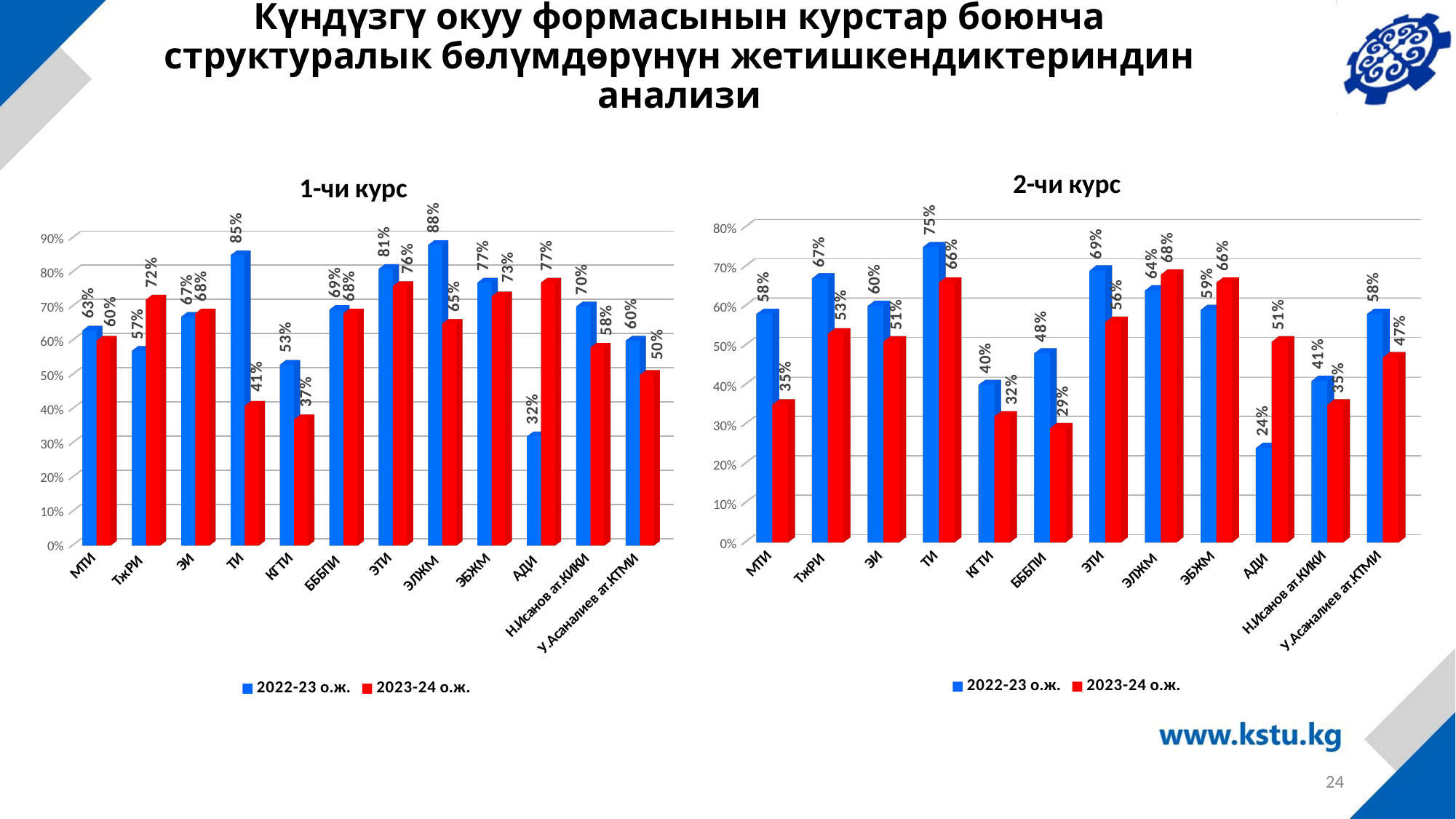
In the "2-чи курс" chart, which is larger for ЭБЖМ: the 2022-23 о.ж. value or the 2023-24 о.ж. value? 2023-24 о.ж. In the "1-чи курс" chart, what is the value for АДИ in the 2023-24 о.ж. series? 77% In the "1-чи курс" chart, which category has the highest value in the 2022-23 о.ж. series? ЭЛЖМ In the "2-чи курс" chart, which category has the lowest value in the 2022-23 о.ж. series? АДИ In the "2-чи курс" chart, which category has the highest value in the 2023-24 о.ж. series? ЭЛЖМ How many series does the legend of the "2-чи курс" chart list? 2 How many categories are shown on the x axis of the "1-чи курс" chart? 12 In the "1-чи курс" chart, what is the difference between the 2022-23 о.ж. and 2023-24 о.ж. values for ТИ? 44% In the "1-чи курс" chart, which category has the lowest value in the 2023-24 о.ж. series? КГТИ In the "2-чи курс" chart, what is the difference between the 2022-23 о.ж. and 2023-24 о.ж. values for МТИ? 23% In the "1-чи курс" chart, what is the value for ТИ in the 2022-23 о.ж. series? 85% In the "2-чи курс" chart, what is the value for БББПИ in the 2023-24 о.ж. series? 29%